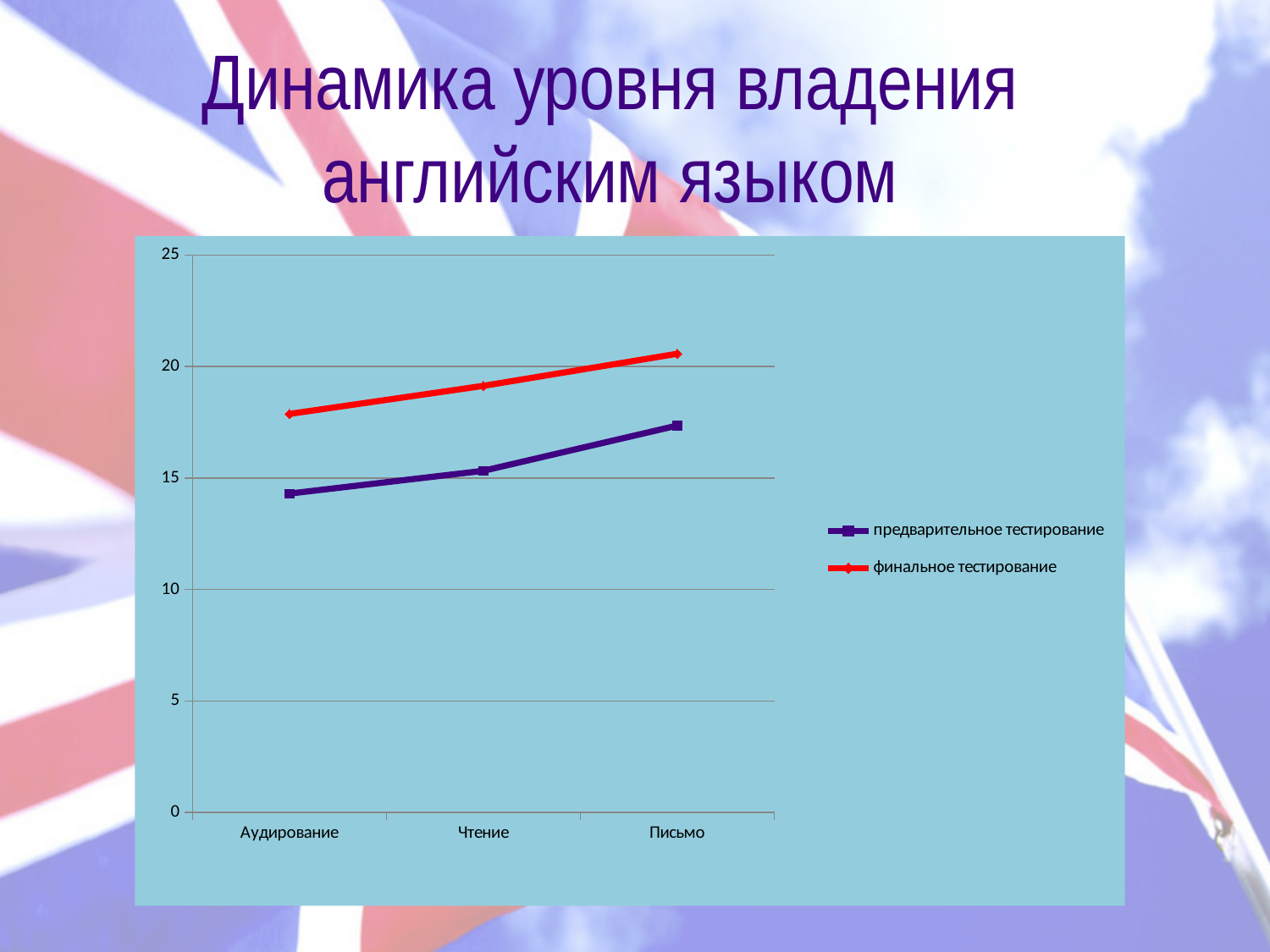
How many categories are shown on the x axis? 3 Which category has the highest value for предварительное тестирование? Письмо What kind of chart is shown on the slide? line chart Which category has the lowest value for финальное тестирование? Аудирование What colour is the line for финальное тестирование? red Do the values for финальное тестирование rise or fall from Аудирование to Письмо? rise Is the value for финальное тестирование at Аудирование greater or less than 20? less Which is larger at Чтение: предварительное тестирование or финальное тестирование? финальное тестирование Is the value for предварительное тестирование at Письмо greater or less than 20? less How many series does the legend list? 2 Is the value for финальное тестирование at Чтение greater or less than 15? greater